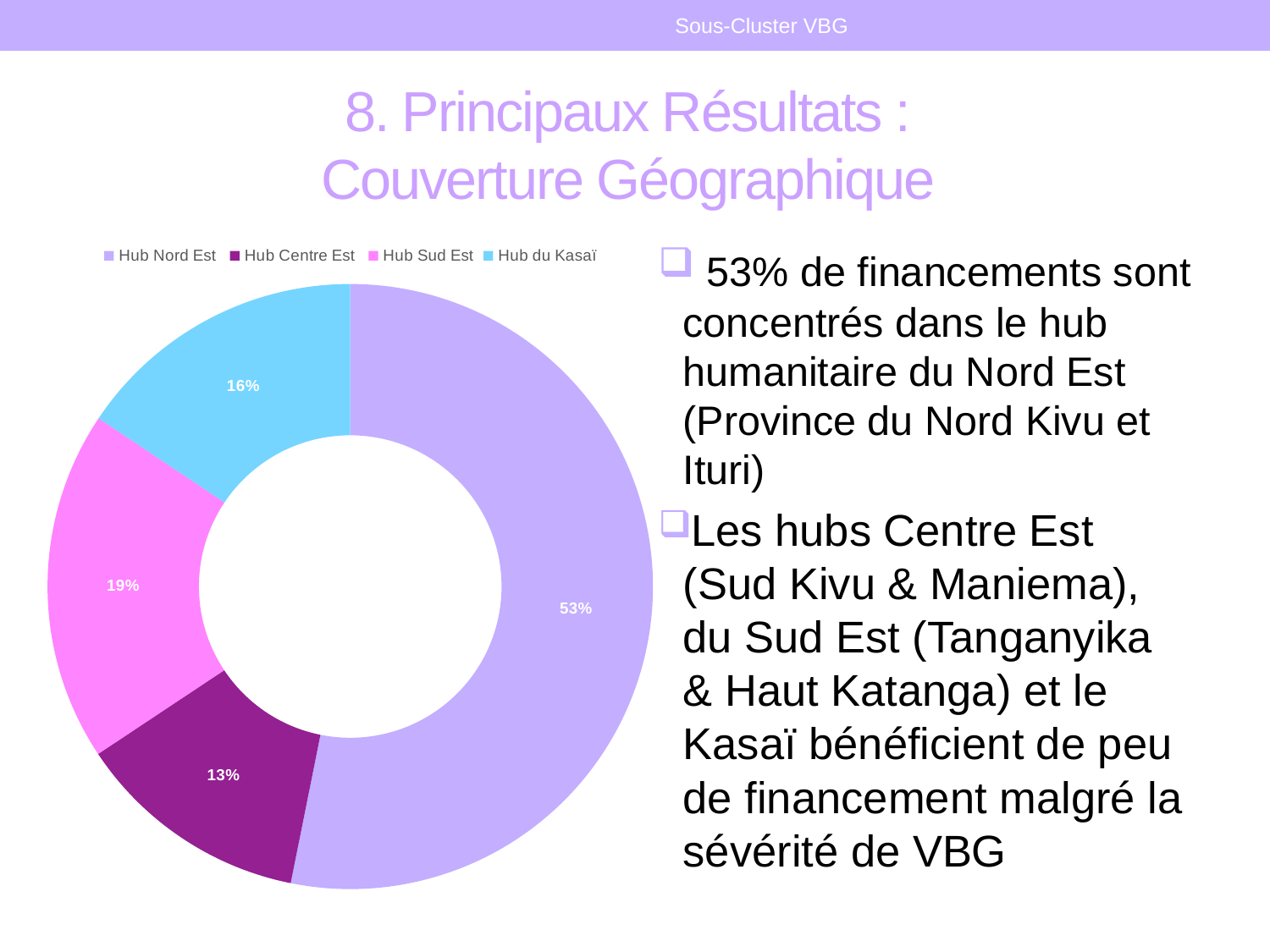
Which is larger, the share for Hub Sud Est or the share for Hub du Kasaï? Hub Sud Est What is the value shown for Hub Sud Est? 19% What is the difference in percentage points between Hub Nord Est and Hub Sud Est? 34 What kind of chart is shown on the slide? Pie chart (doughnut) How many categories are shown in the chart? 4 What share of the pie does Hub Nord Est represent? 53% What is the difference in percentage points between Hub du Kasaï and Hub Centre Est? 3 What is the value shown for Hub du Kasaï? 16% Which legend entry is shown in light blue? Hub du Kasaï Which hub has the largest share of the chart? Hub Nord Est What is the value shown for Hub Centre Est? 13% Which hub has the smallest share of the chart? Hub Centre Est